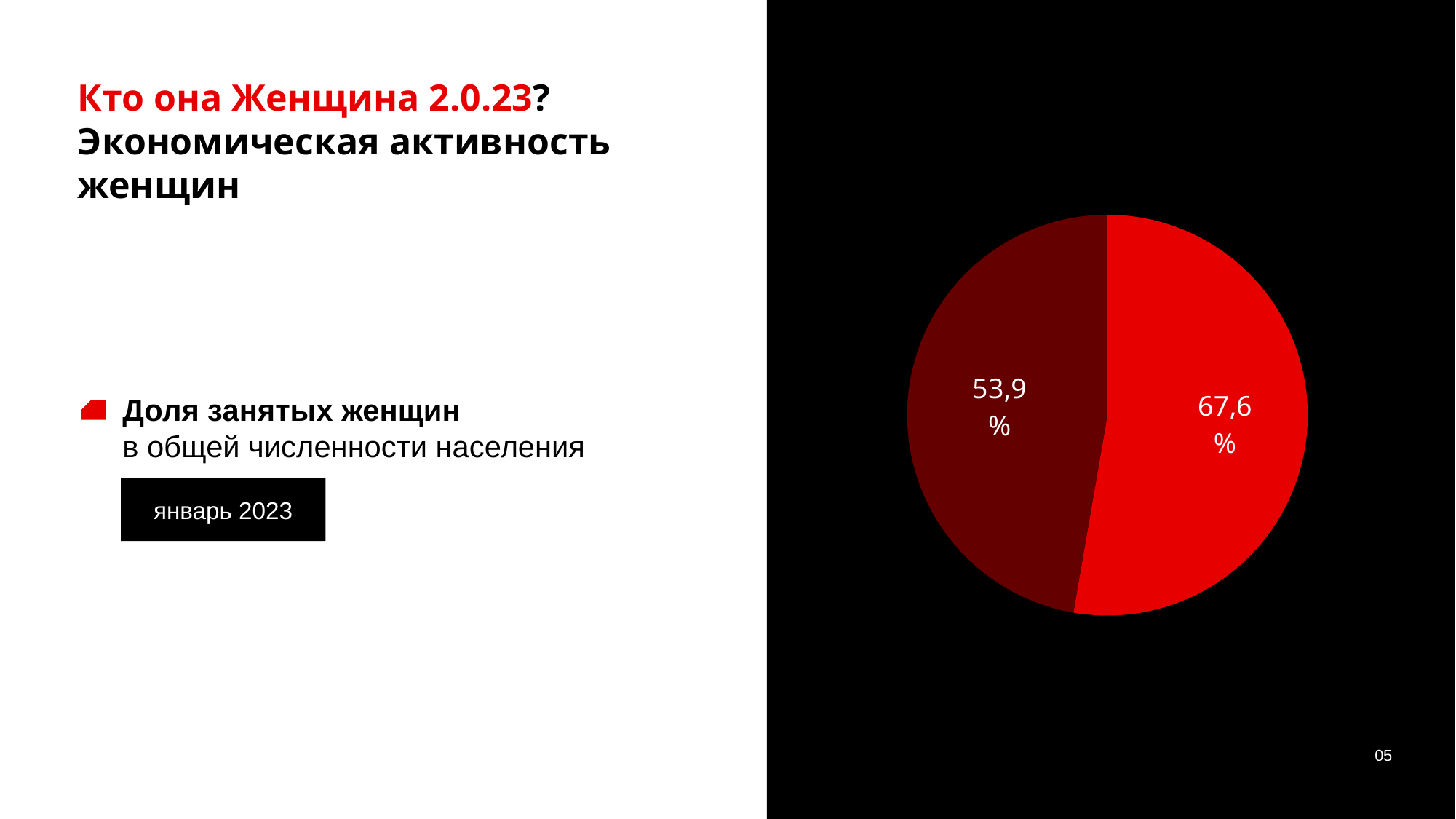
What is the background colour of the area where the pie chart is placed? black What is the smallest value shown on the pie chart? 53,9% What is the difference between the two values printed on the pie chart? 13,7 What value is printed on the bright red slice of the pie chart? 67,6% Is the value on the dark red slice greater or less than 60%? less Is the value on the bright red slice greater or less than 60%? greater How many slices does the pie chart have? 2 Which slice of the pie chart has the larger value, the bright red one or the dark red one? the bright red one What period is indicated in the black box below the chart description? январь 2023 What value is printed on the dark red slice of the pie chart? 53,9% What is the largest value shown on the pie chart? 67,6% What kind of chart is shown on the slide? pie chart